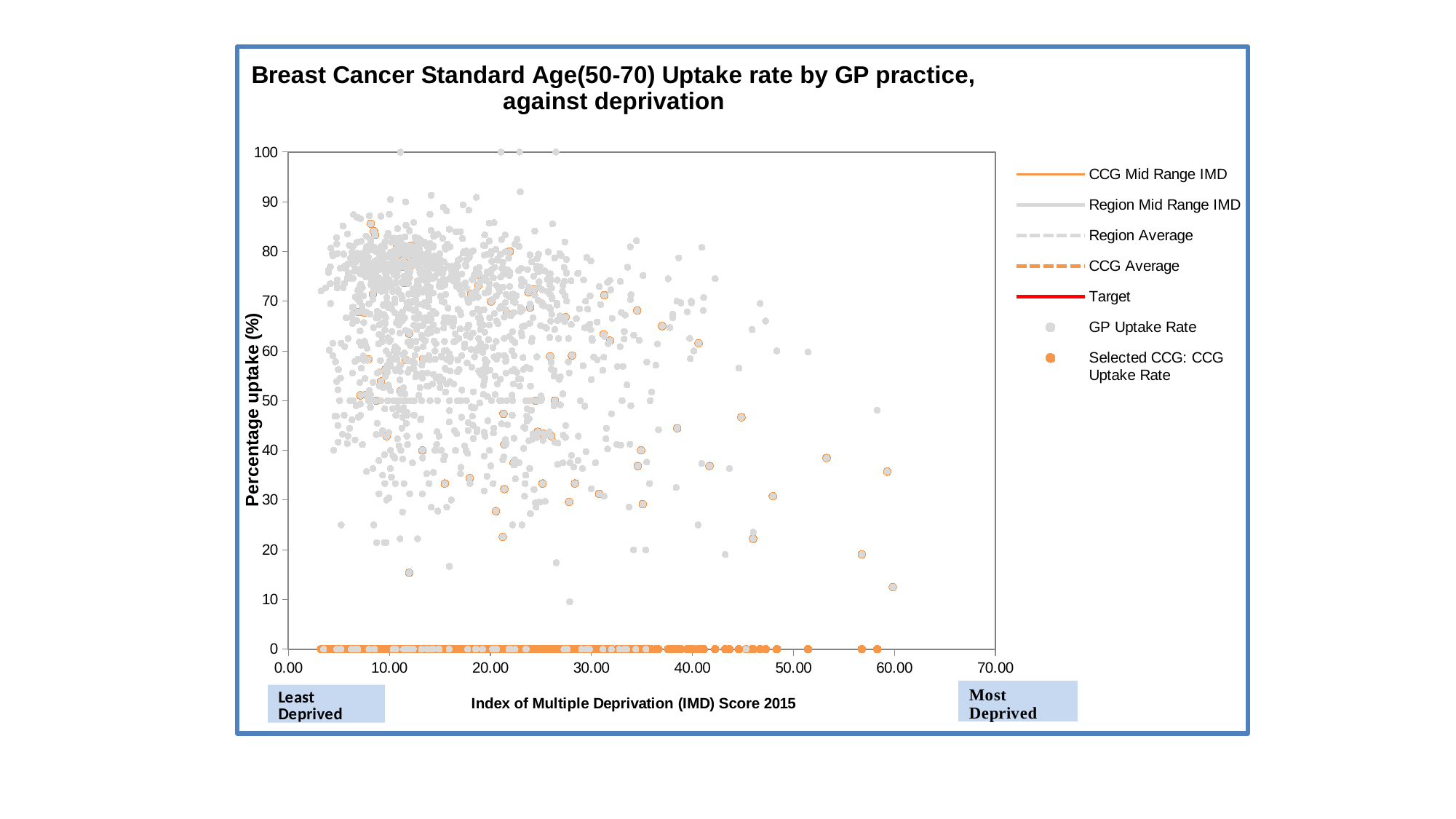
What kind of chart is shown on the slide? Scatter chart How many entries does the chart legend list? 7 Is the highest Selected CCG: CCG Uptake Rate point plotted greater or less than 80? greater What is the label of the vertical axis? Percentage uptake (%) As the IMD score increases along the x axis, do the GP uptake rates generally rise or fall? Fall Is the highest GP Uptake Rate point plotted greater or less than 90? greater What is the title of the chart? Breast Cancer Standard Age(50-70) Uptake rate by GP practice, against deprivation Is the lowest non-zero GP Uptake Rate point plotted greater or less than 20? less